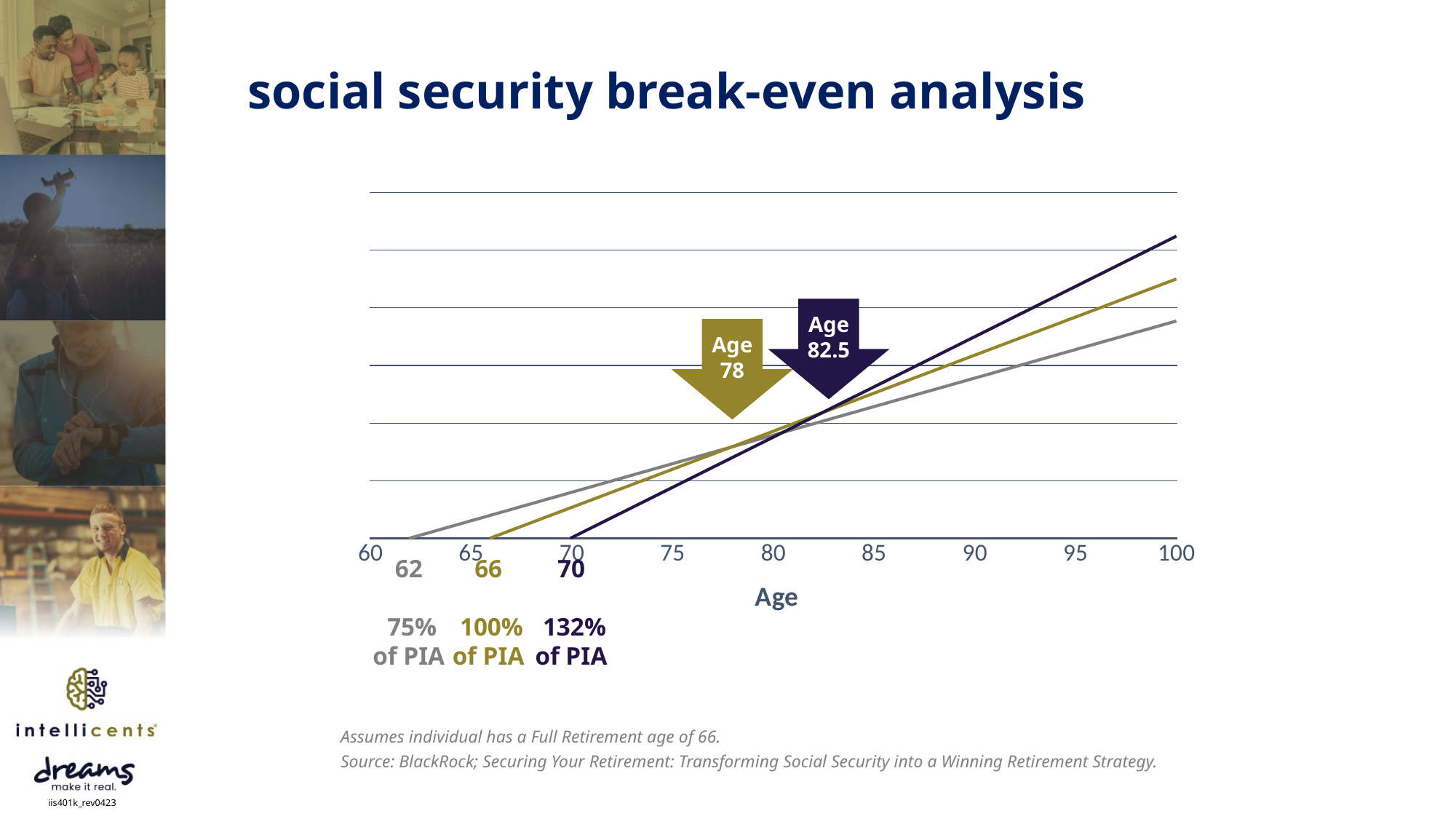
What is the label of the x axis? Age What percentage of PIA is shown for claiming at age 62? 75% of PIA What break-even age is marked by the gold arrow? Age 78 What break-even age is marked by the dark navy arrow? Age 82.5 How many lines are plotted on the chart? 3 Do the plotted lines rise or fall as age increases? rise What kind of chart is shown on the slide? line chart What percentage of PIA is shown for claiming at age 70? 132% of PIA At age 100, which line is highest: the gray (62), gold (66) or dark navy (70) line? dark navy (70) At what age does the dark navy line begin? 70 At what age does the gray line begin? 62 What is the title of the slide's chart? social security break-even analysis